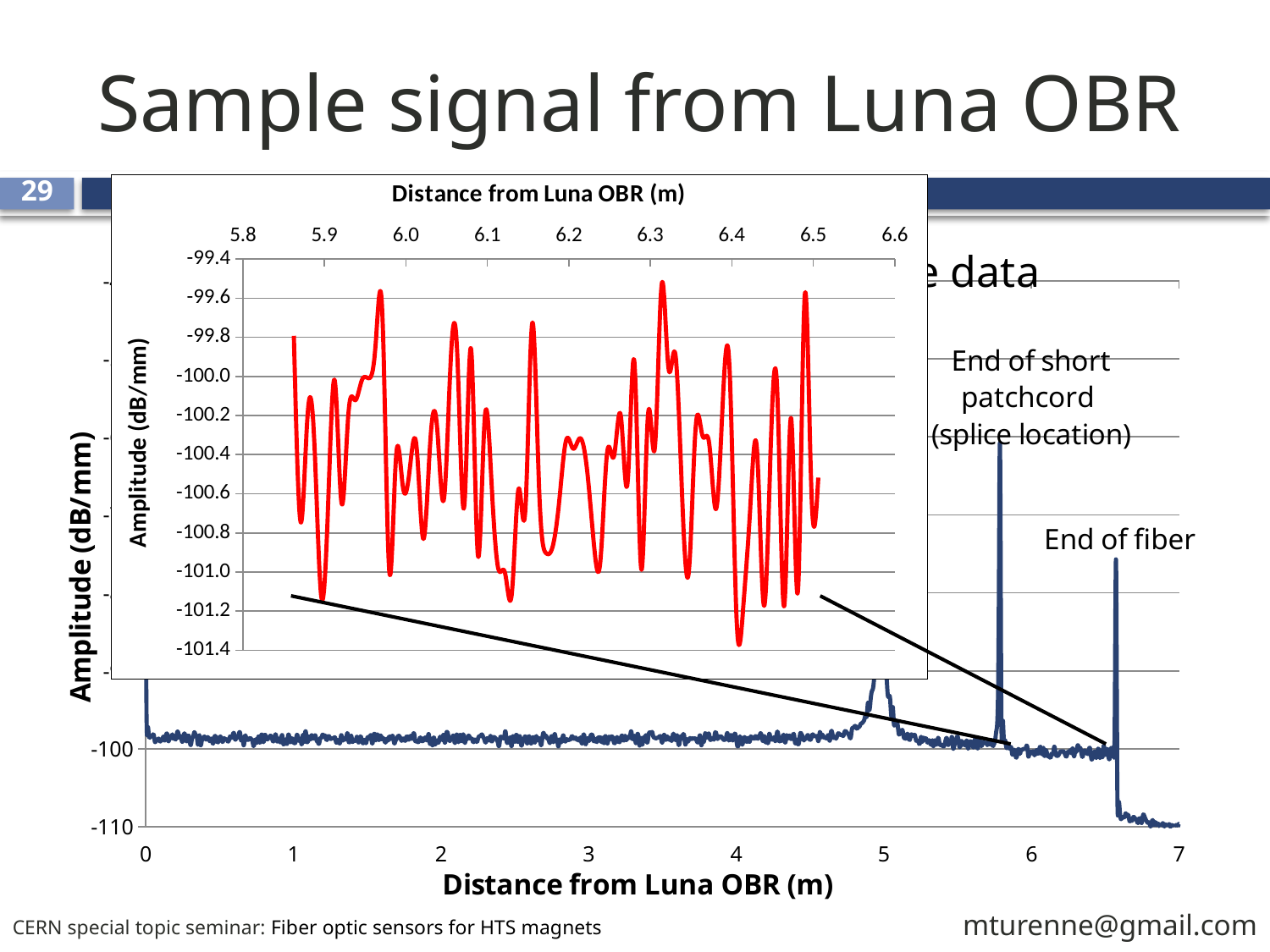
On the inset chart, what is the highest value shown on the x axis? 6.6 On the inset chart, is the peak value near 6.3 m greater or less than -100.0? greater On the inset chart, what is the lowest value shown on the x axis? 5.8 On the large chart, what is the highest value shown on the x axis? 7 On the inset chart, what is the highest value shown on the y axis? -99.4 On the inset chart, what is the lowest value shown on the y axis? -101.4 On the large chart, what label is given to the peak near 6.5 m? End of fiber On the large chart, how many tick labels are shown on the x axis? 8 What kind of chart is the large chart with the x axis 'Distance from Luna OBR (m)' running from 0 to 7? line chart On the large chart, is the amplitude at a distance of 3 m greater or less than -110? greater What kind of chart is the inset chart titled 'Distance from Luna OBR (m)'? line chart On the large chart, is the amplitude at a distance of 6.8 m greater or less than -100? less